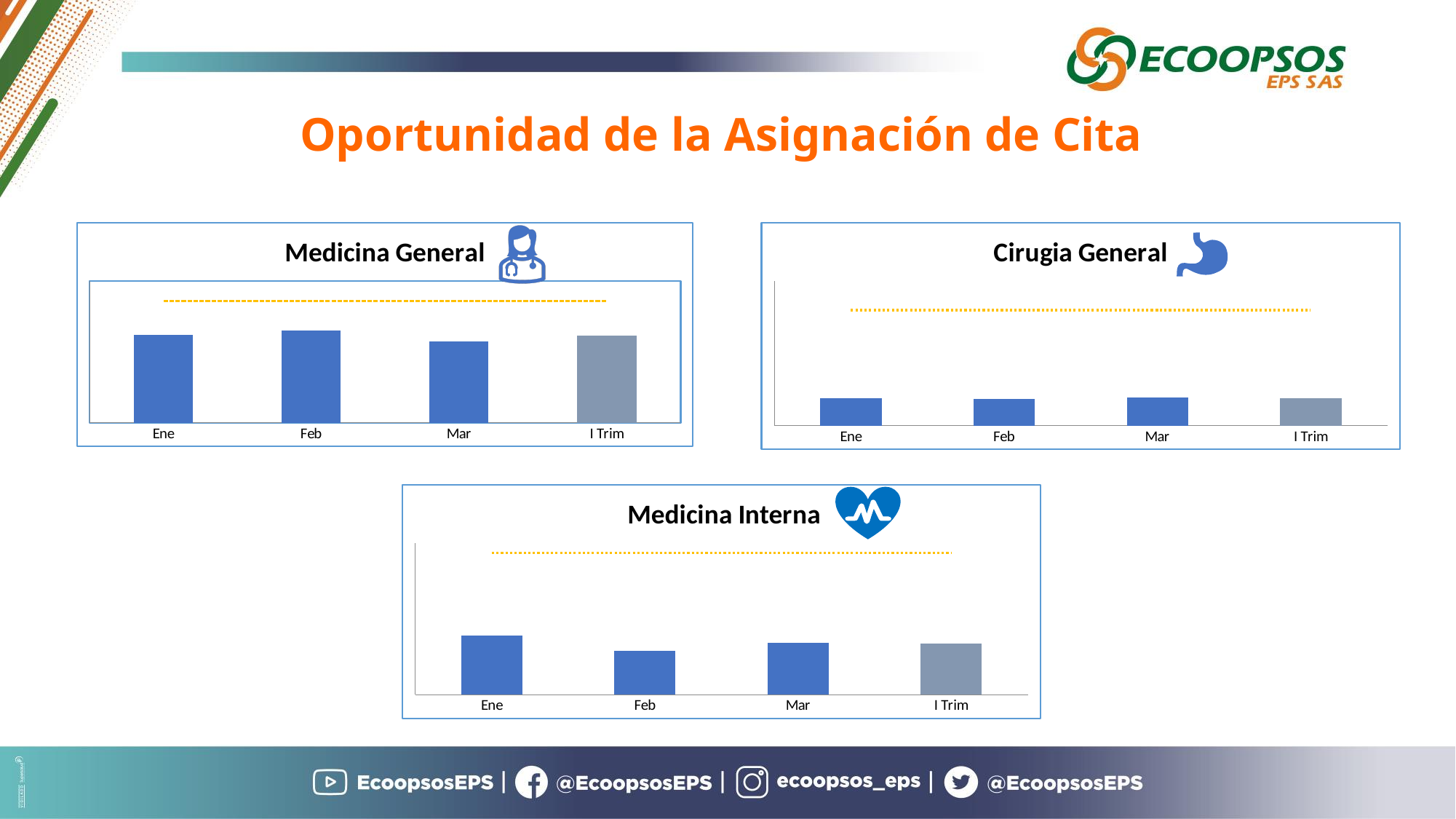
In the Medicina General chart, which category's bar is coloured grey instead of blue? I Trim How many categories are shown on the x axis of the Cirugia General chart? 4 What are the titles of the three charts on the slide? Medicina General, Cirugia General, Medicina Interna In the Medicina Interna chart, which category has the highest bar? Ene What kind of chart is the Medicina General chart? combination bar and line chart In the Medicina Interna chart, which category has the lowest bar? Feb In the Medicina General chart, is the bar for Ene or Mar taller? Ene In the Medicina General chart, is the bar for Feb or Mar taller? Feb How many categories are shown on the x axis of the Medicina Interna chart? 4 What is the label of the last category on the x axis of the Cirugia General chart? I Trim In the Medicina Interna chart, is the bar for Ene or Feb taller? Ene